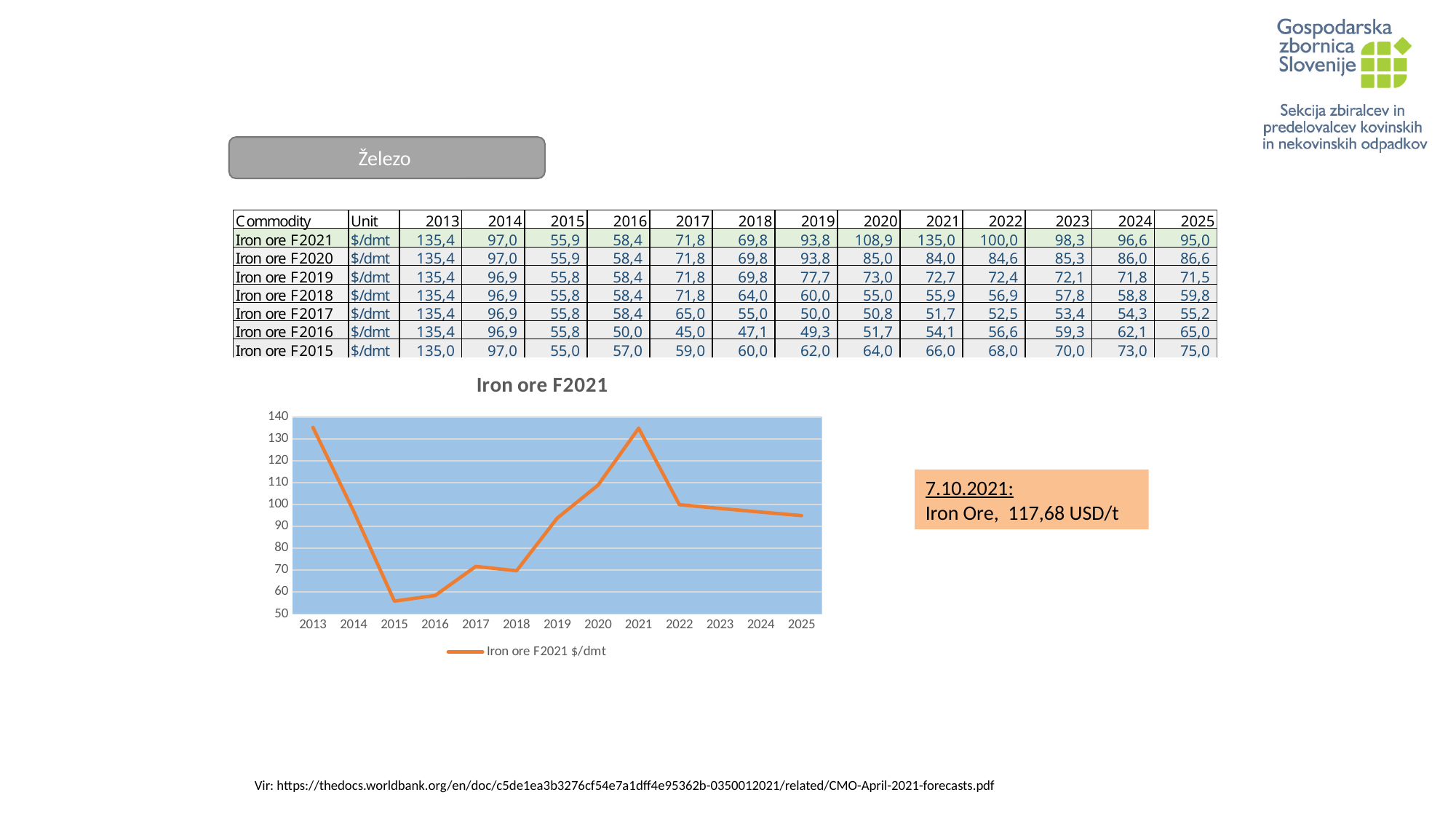
What is the legend entry of the chart? Iron ore F2021 $/dmt In the Iron ore F2021 chart, which year has the lowest value? 2015 In the Iron ore F2021 chart, do the values rise or fall from 2021 to 2025? fall In the Iron ore F2021 chart, is the value for 2021 greater or less than 130? greater What is the difference between the Iron ore F2021 values for 2021 and 2022? 35,0 What kind of chart is shown on the slide? line chart In the Iron ore F2021 chart, is the value for 2015 greater or less than 60? less In the Iron ore F2021 chart, which year has the larger value, 2019 or 2022? 2022 What is the Iron ore F2021 value for 2025? 95,0 How many series does the legend of the Iron ore F2021 chart list? 1 How many years are plotted on the x axis of the Iron ore F2021 chart? 13 What is the Iron ore F2021 value for 2020? 108,9